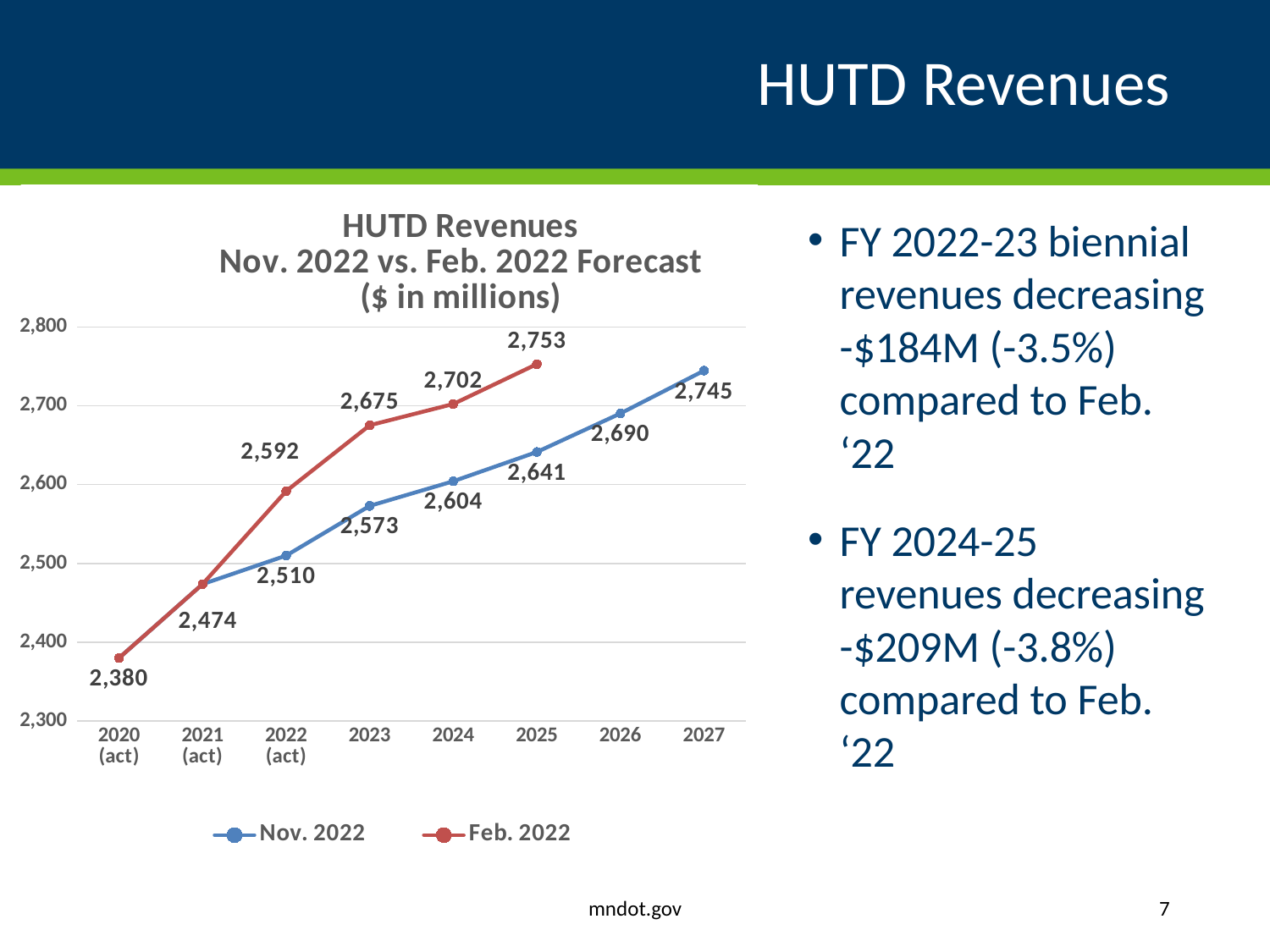
How many years are shown on the x axis of the chart? 8 What is the Nov. 2022 value for 2023? 2,573 What kind of chart is shown on the slide? Line chart Does the Nov. 2022 series rise or fall from 2020 to 2027? Rise What is the Feb. 2022 forecast value for 2025? 2,753 What is the Nov. 2022 forecast value for 2027? 2,745 For 2024, which series has the larger value, Nov. 2022 or Feb. 2022? Feb. 2022 Which year has the lowest value on the chart? 2020 (act) What is the difference between the Feb. 2022 and Nov. 2022 values for 2023? 102 What is the difference between the Feb. 2022 and Nov. 2022 values for 2022 (act)? 82 How many series does the chart legend list? 2 In which year does the Feb. 2022 series reach its highest value? 2025